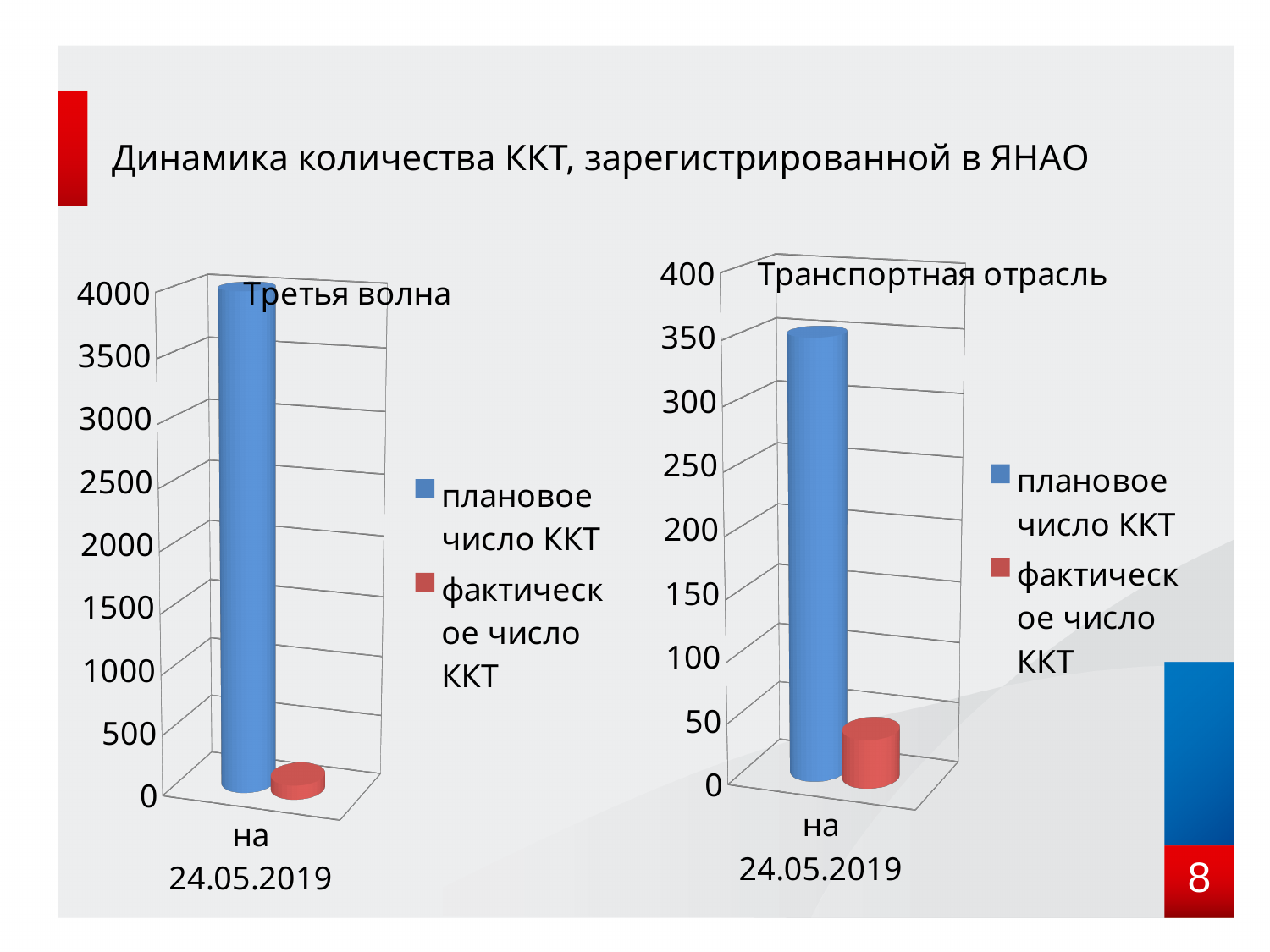
In the chart "Третья волна", how many series does the legend list? 2 In the chart "Транспортная отрасль", is the value for "фактическое число ККТ" greater or less than 100? less In the chart "Третья волна", is the value for "плановое число ККТ" greater or less than 3500? greater What type of chart is the right chart titled "Транспортная отрасль"? bar chart What is the x-axis category label in the chart "Третья волна"? на 24.05.2019 In the chart "Третья волна", which series is larger: "плановое число ККТ" or "фактическое число ККТ"? плановое число ККТ In the chart "Третья волна", is the value for "фактическое число ККТ" greater or less than 500? less What type of chart is the left chart titled "Третья волна"? bar chart In the chart "Транспортная отрасль", what colour represents "фактическое число ККТ"? red In the chart "Транспортная отрасль", which series has the lowest value? фактическое число ККТ In the chart "Транспортная отрасль", how many categories are shown on the x axis? 1